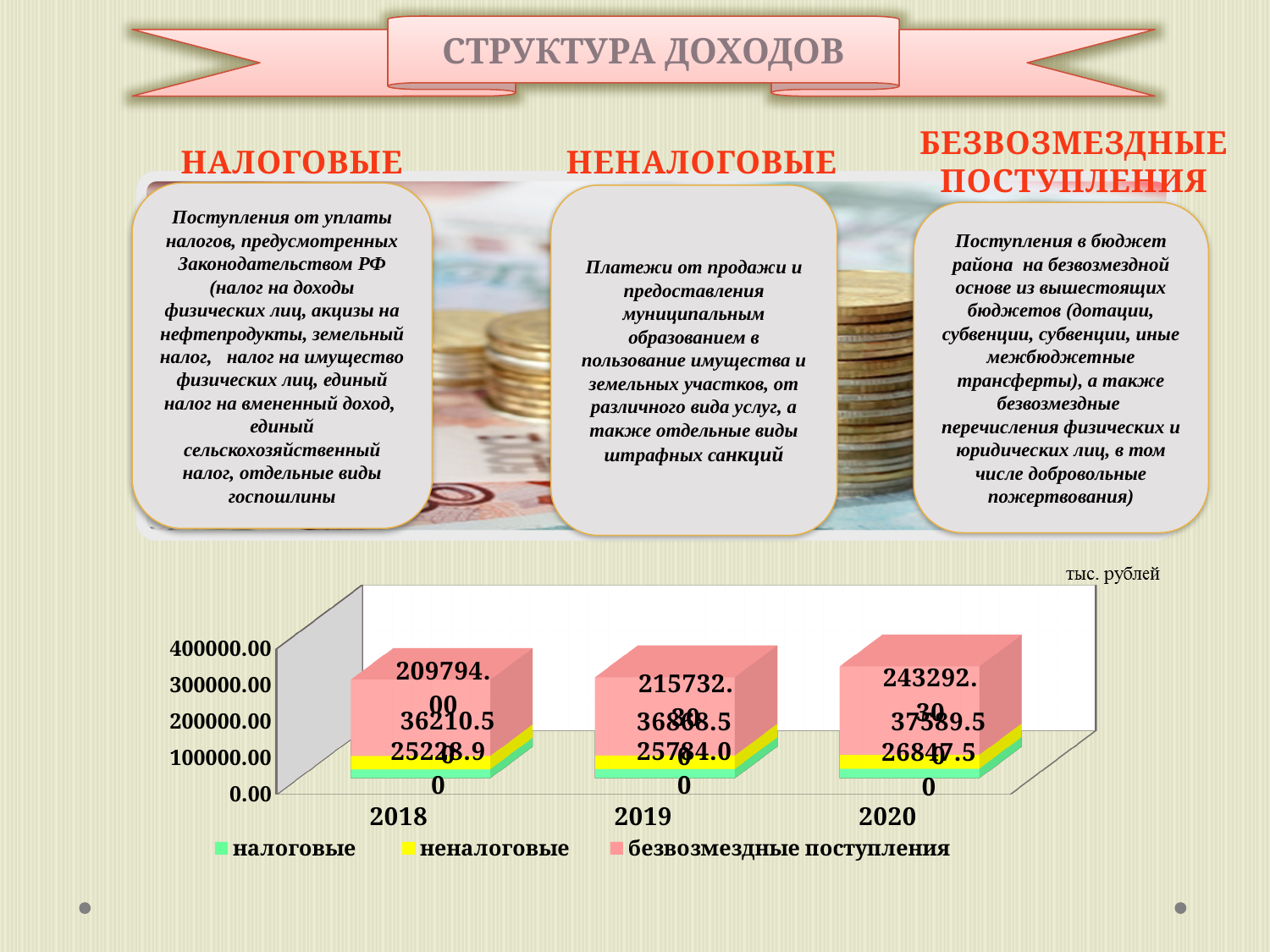
What is the value of безвозмездные поступления for 2018? 209794.00 What unit is indicated above the chart? тыс. рублей Do the values of безвозмездные поступления rise or fall from 2018 to 2020? rise How many series does the chart legend list? 3 What kind of chart is shown at the bottom of the slide? bar chart How many years are shown on the x axis of the chart? 3 In which year is the value of безвозмездные поступления the highest? 2020 What is the value of безвозмездные поступления for 2020? 243292.30 What is the difference between безвозмездные поступления in 2020 and in 2018? 33498.30 What is the value of безвозмездные поступления for 2019? 215732.30 Which is larger in 2018: безвозмездные поступления or налоговые? безвозмездные поступления Is the value of безвозмездные поступления for 2020 greater or less than 200000.00? greater